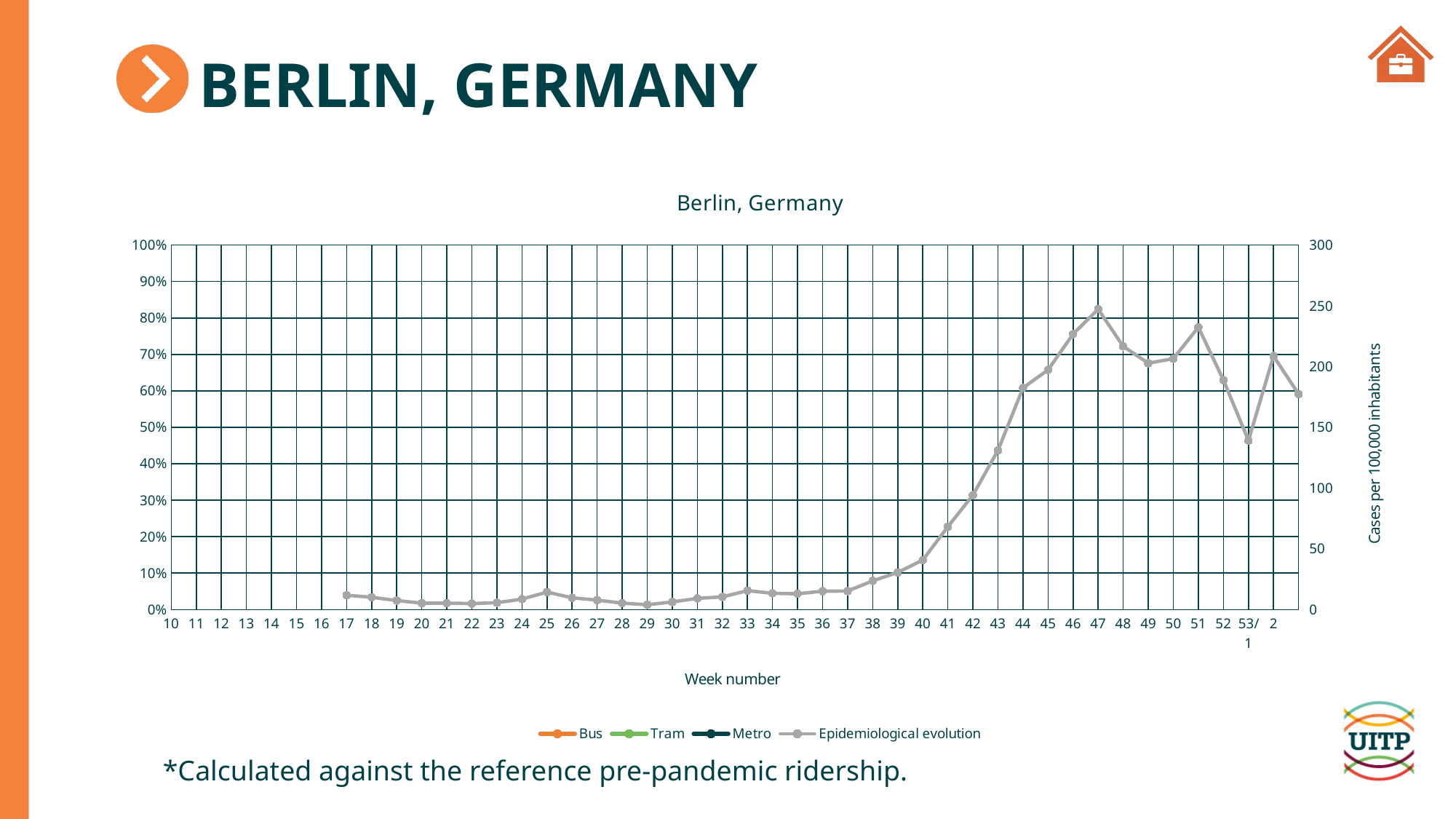
Is the Epidemiological evolution value at week 44 greater or less than 150 cases per 100,000 inhabitants? greater What is the title of the chart? Berlin, Germany Which is higher on the Epidemiological evolution line, week 47 or week 51? Week 47 Is the Epidemiological evolution value at week 53/1 greater or less than 150 cases per 100,000 inhabitants? less What is the label of the right-hand vertical axis? Cases per 100,000 inhabitants At which week number does the Epidemiological evolution line reach its highest point? 47 How many series does the legend list? 4 Is the Epidemiological evolution value at week 46 greater or less than 200 cases per 100,000 inhabitants? greater Which is higher on the Epidemiological evolution line, week 53/1 or week 2? Week 2 Does the Epidemiological evolution line rise or fall between week 37 and week 47? Rise What kind of chart is shown on the slide? Line chart